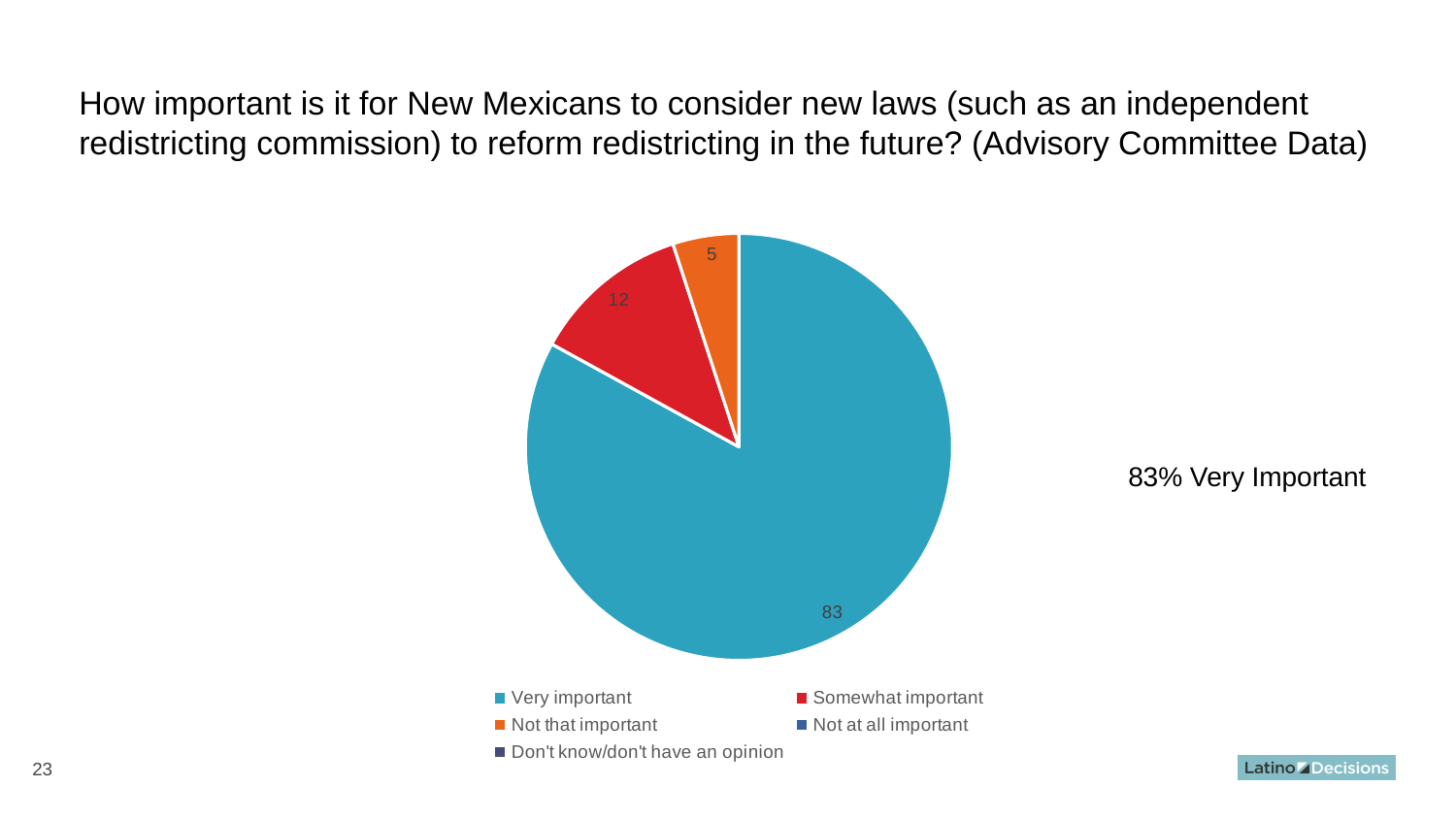
What is the difference between the "Somewhat important" value and the "Not that important" value? 7 What is the value shown for the "Not that important" slice? 5 What text is shown to the right of the pie chart? 83% Very Important Which labelled slice of the pie is the smallest? Not that important Which response category has the largest slice of the pie? Very important What is the value shown for the "Somewhat important" slice? 12 What is the difference between the "Very important" value and the "Somewhat important" value? 71 Which is larger, the "Somewhat important" slice or the "Not that important" slice? Somewhat important What colour is the "Very important" slice? blue What is the value shown for the "Very important" slice? 83 What kind of chart is shown on the slide? pie chart How many entries does the legend list? 5